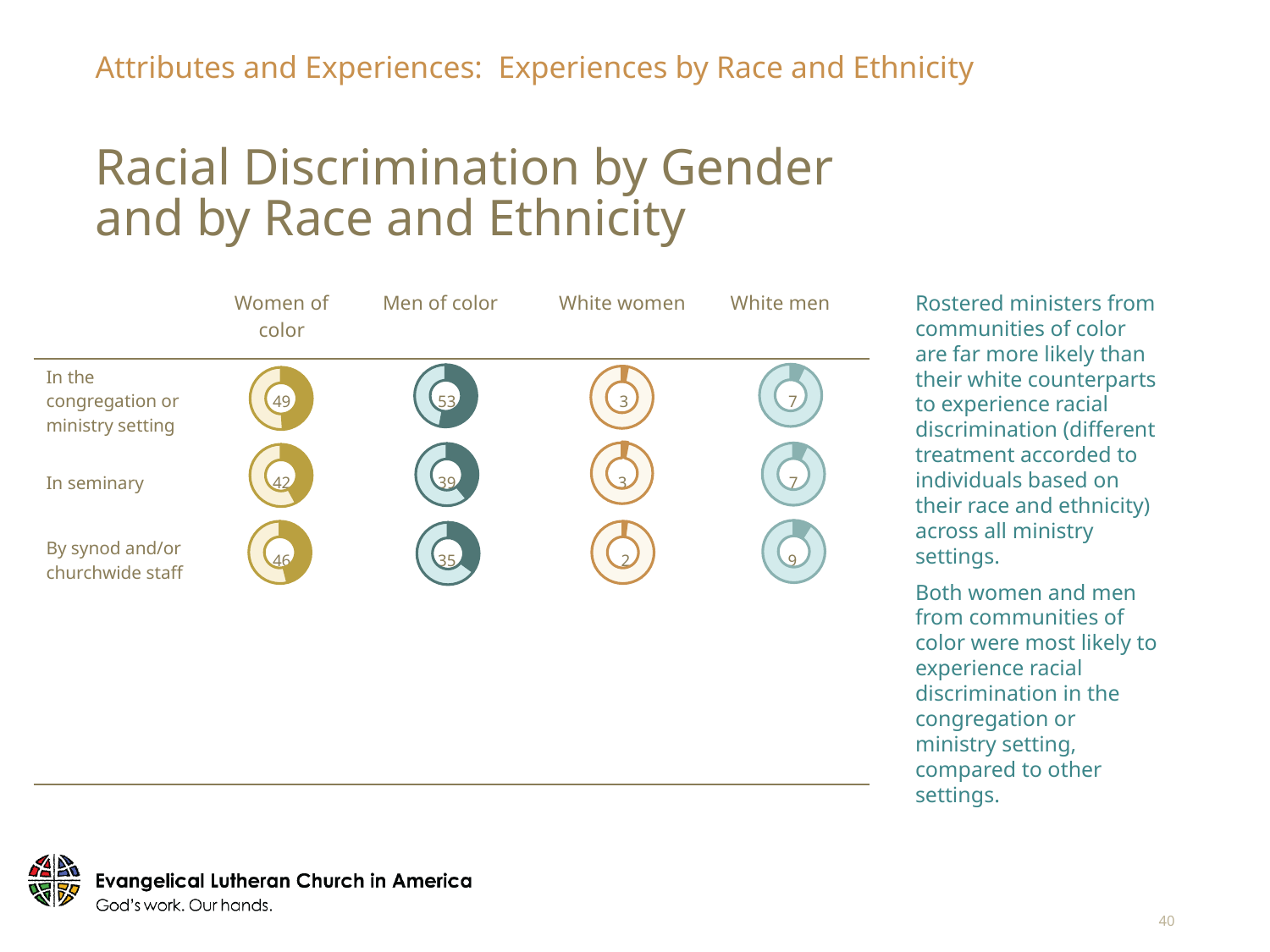
What kind of chart is used to display the values on this slide? Donut chart What value is shown in the donut chart for White women in seminary? 3 Across the four donut charts in the 'By synod and/or churchwide staff' row, which group has the lowest value? White women What is the difference between the Women of color value and the Men of color value in the 'In seminary' row? 3 What value is shown in the donut chart for Men of color in seminary? 39 In the 'By synod and/or churchwide staff' row, which is larger: the value for Women of color or the value for Men of color? Women of color What value is shown in the donut chart for Women of color in the congregation or ministry setting? 49 Across the four donut charts in the 'In the congregation or ministry setting' row, which group has the highest value? Men of color Among the three donut charts for Men of color, which ministry setting has the lowest value? By synod and/or churchwide staff What value is shown in the donut chart for White men by synod and/or churchwide staff? 9 What is the difference between the White men value and the White women value in the 'In the congregation or ministry setting' row? 4 How many donut charts are shown on the slide? 12